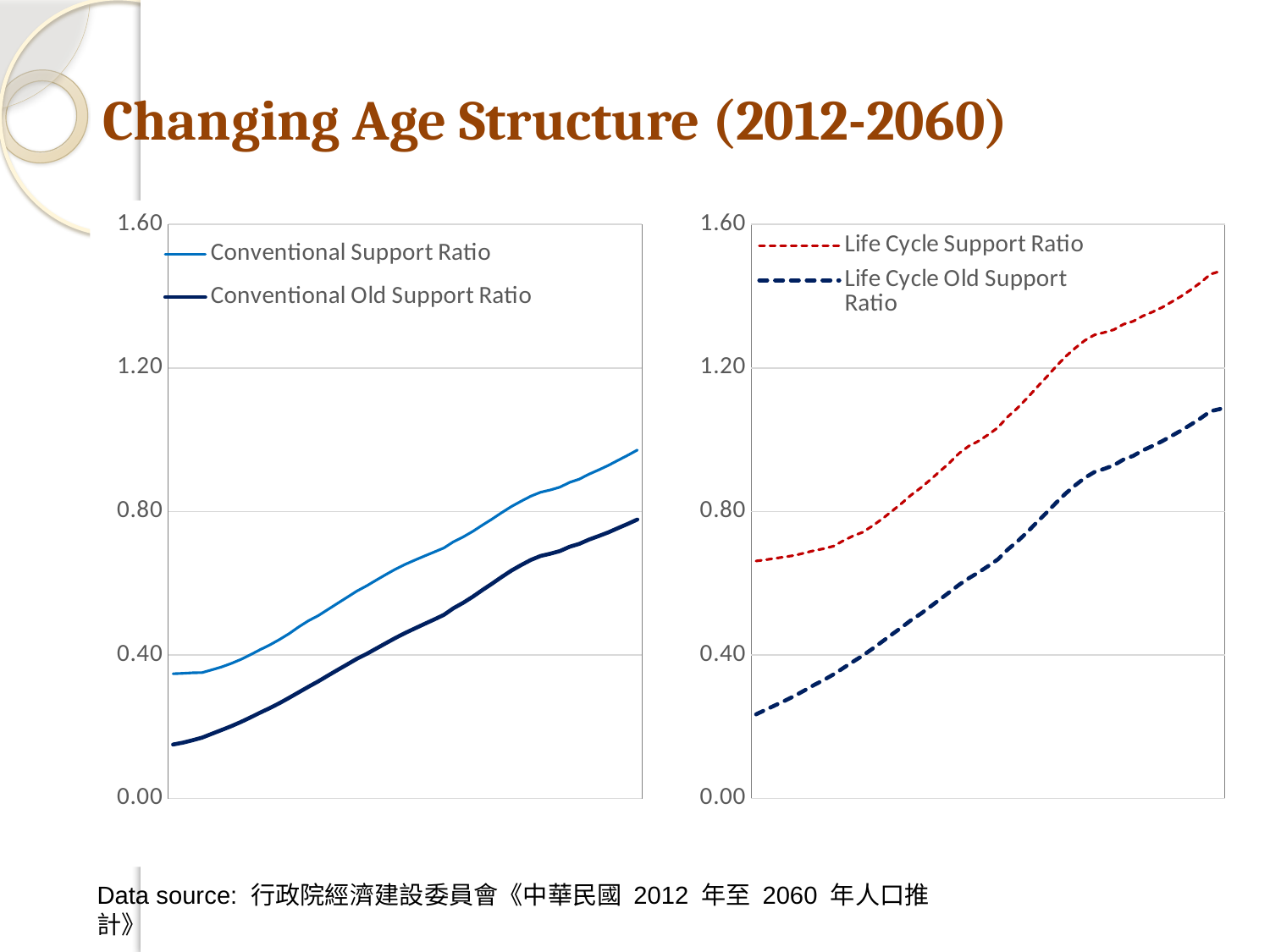
In the right chart, what colour is the Life Cycle Support Ratio line? red In the left chart, which series is higher at the right end of the x axis, Conventional Support Ratio or Conventional Old Support Ratio? Conventional Support Ratio In the right chart, is the final value of the Life Cycle Support Ratio greater or less than 1.20? greater What kind of chart is the left chart on the slide? line chart In the left chart, is the starting value of the Conventional Old Support Ratio greater or less than 0.40? less In the left chart, is the final value of the Conventional Support Ratio greater or less than 0.80? greater How many series does the legend of the left chart list? 2 How many series does the legend of the right chart list? 2 In the right chart, which series is higher at the start of the x axis, Life Cycle Support Ratio or Life Cycle Old Support Ratio? Life Cycle Support Ratio In the right chart, does the Life Cycle Old Support Ratio rise or fall along the x axis? rise In the left chart, does the Conventional Support Ratio rise or fall along the x axis? rise